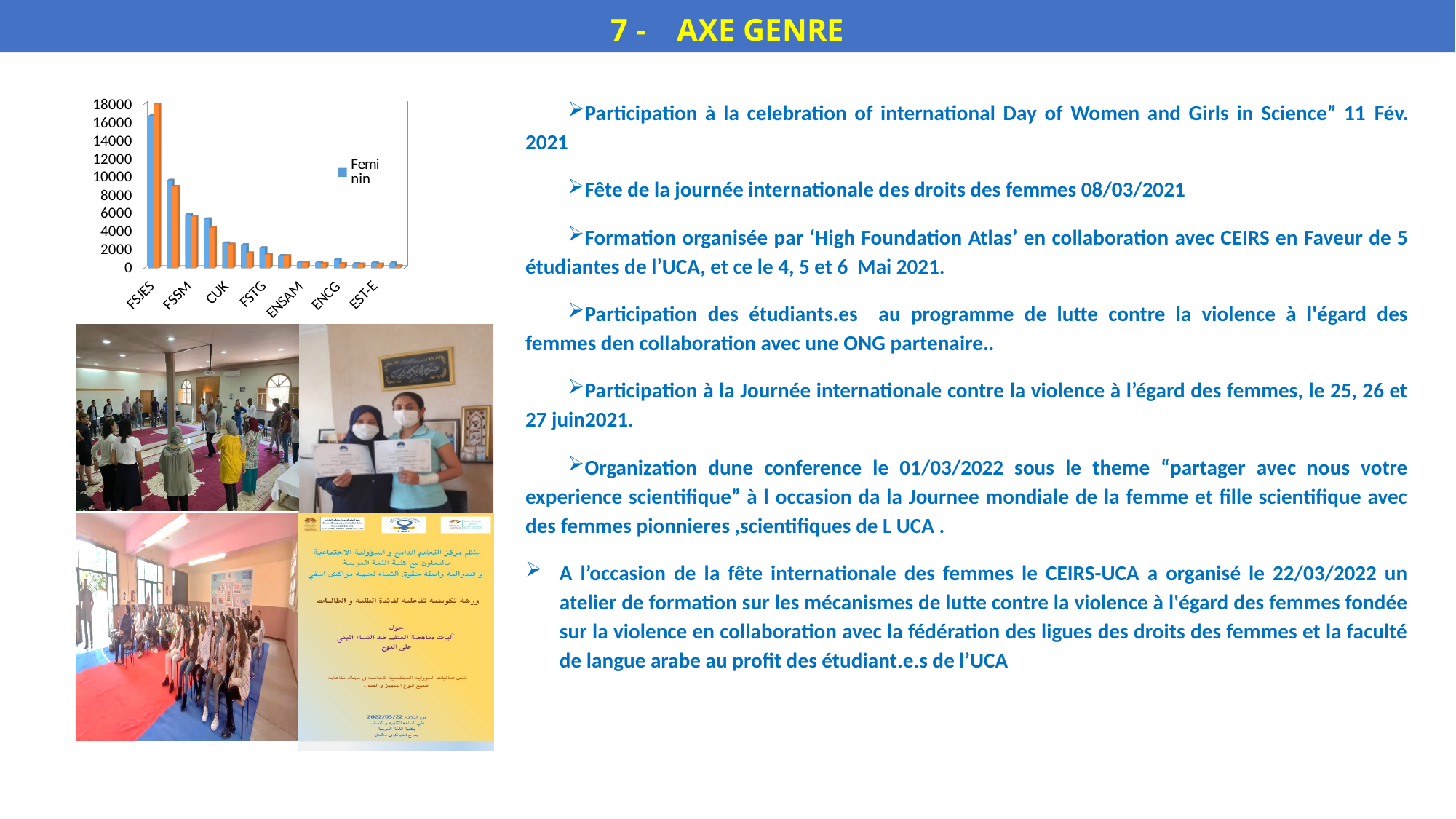
Is the value of the blue bar for ENSAM greater or less than 2000? less What is the highest value shown on the vertical axis of the chart? 18000 Is the value of the blue bar for FSJES greater or less than 14000? greater Is the value of the blue bar for FSTG greater or less than 4000? less What entry does the chart legend list? Feminin Do the bar values rise or fall from left to right along the x axis? fall Which has the larger blue bar, FSJES or FSSM? FSJES What kind of chart is shown on the left of the slide? bar chart Which category has the highest bars in the chart? FSJES Which has the larger blue bar, CUK or FSTG? CUK